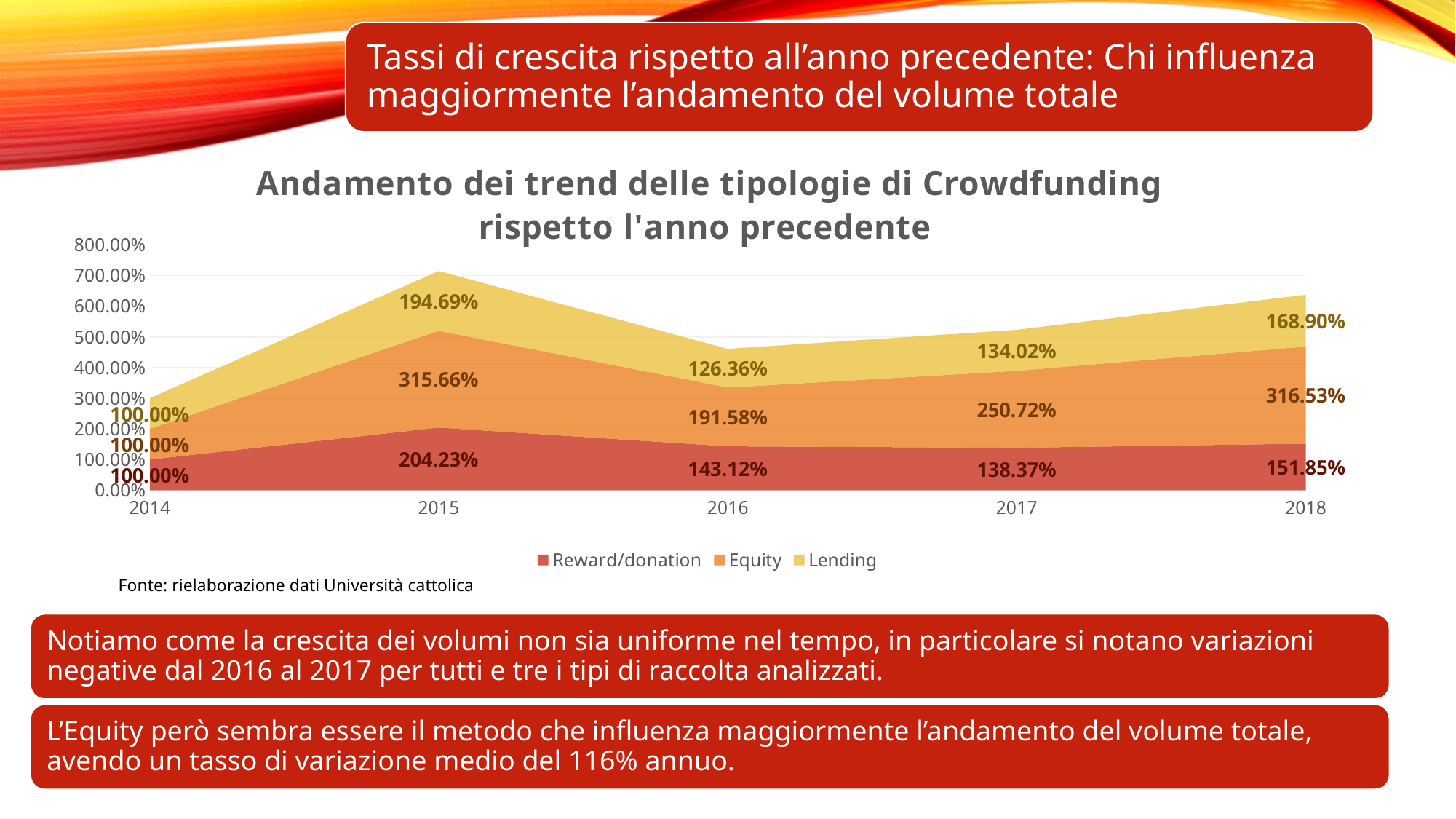
In which year is the Equity value highest? 2018 How many series does the legend list? 3 Which is larger in 2016: the Equity value or the Lending value? Equity What is the value for Lending in 2017? 134.02% What kind of chart is this? Stacked area chart What is the difference between the Equity value and the Reward/donation value in 2017? 112.35% What is the value for Equity in 2015? 315.66% How many years are shown on the x axis? 5 What is the value for Reward/donation in 2016? 143.12% In which year is the Lending value lowest? 2014 What is the value for Lending in 2018? 168.90% What is the total of the three stacked values in 2015? 714.58%